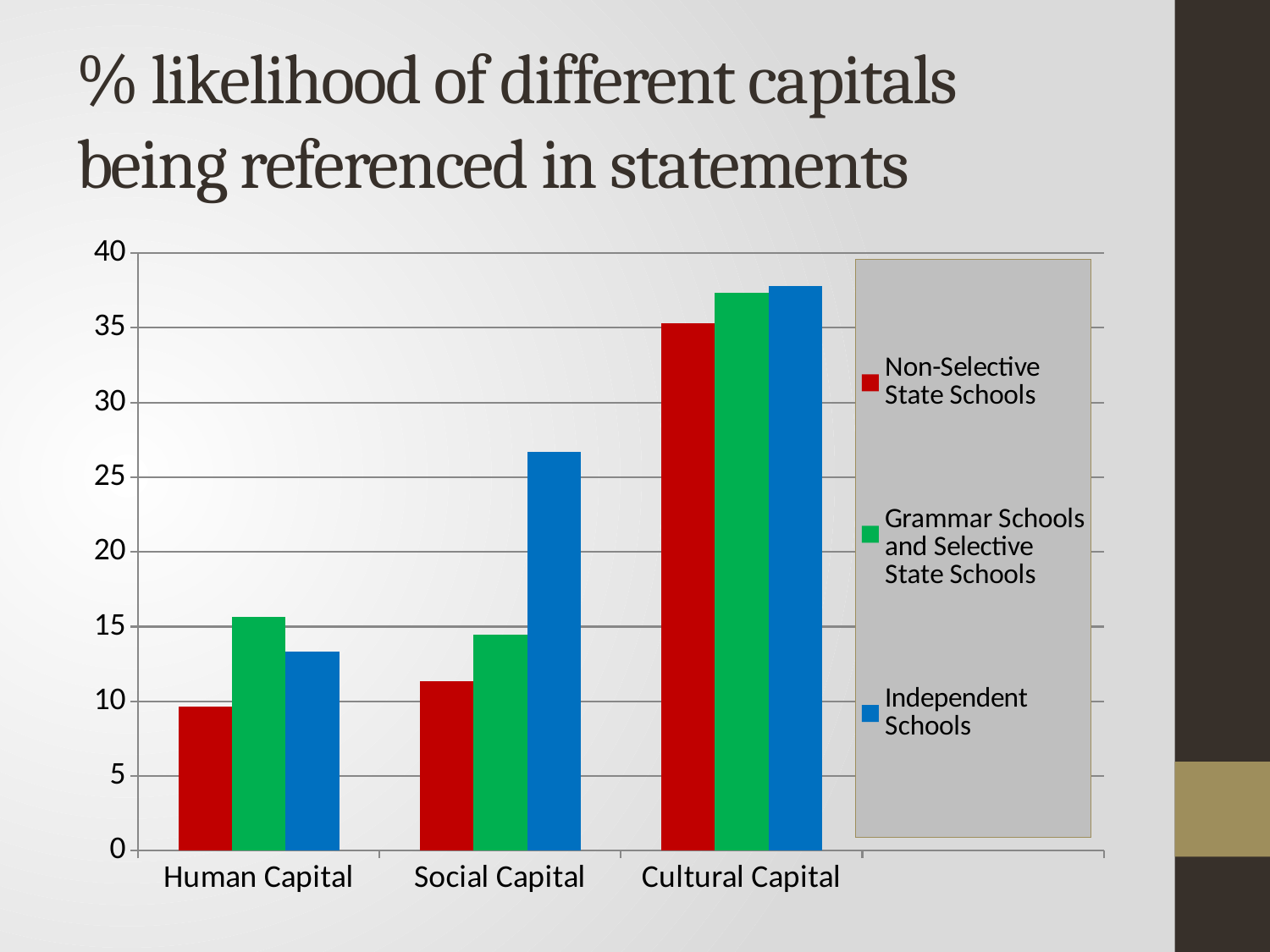
What kind of chart is shown on the slide? bar chart How many categories are shown on the x axis? 3 Is the value for Independent Schools at Human Capital greater or less than 15? less Is the value for Grammar Schools and Selective State Schools at Cultural Capital greater or less than 35? greater For Human Capital, which is larger: Grammar Schools and Selective State Schools or Independent Schools? Grammar Schools and Selective State Schools Which series is shown in blue in the legend? Independent Schools How many series does the legend list? 3 For Social Capital, which is larger: Independent Schools or Non-Selective State Schools? Independent Schools Which category has the lowest value for Independent Schools? Human Capital Which category has the highest value for Non-Selective State Schools? Cultural Capital Is the value for Independent Schools at Social Capital greater or less than 25? greater Do the values for Non-Selective State Schools rise or fall from Human Capital to Cultural Capital? rise